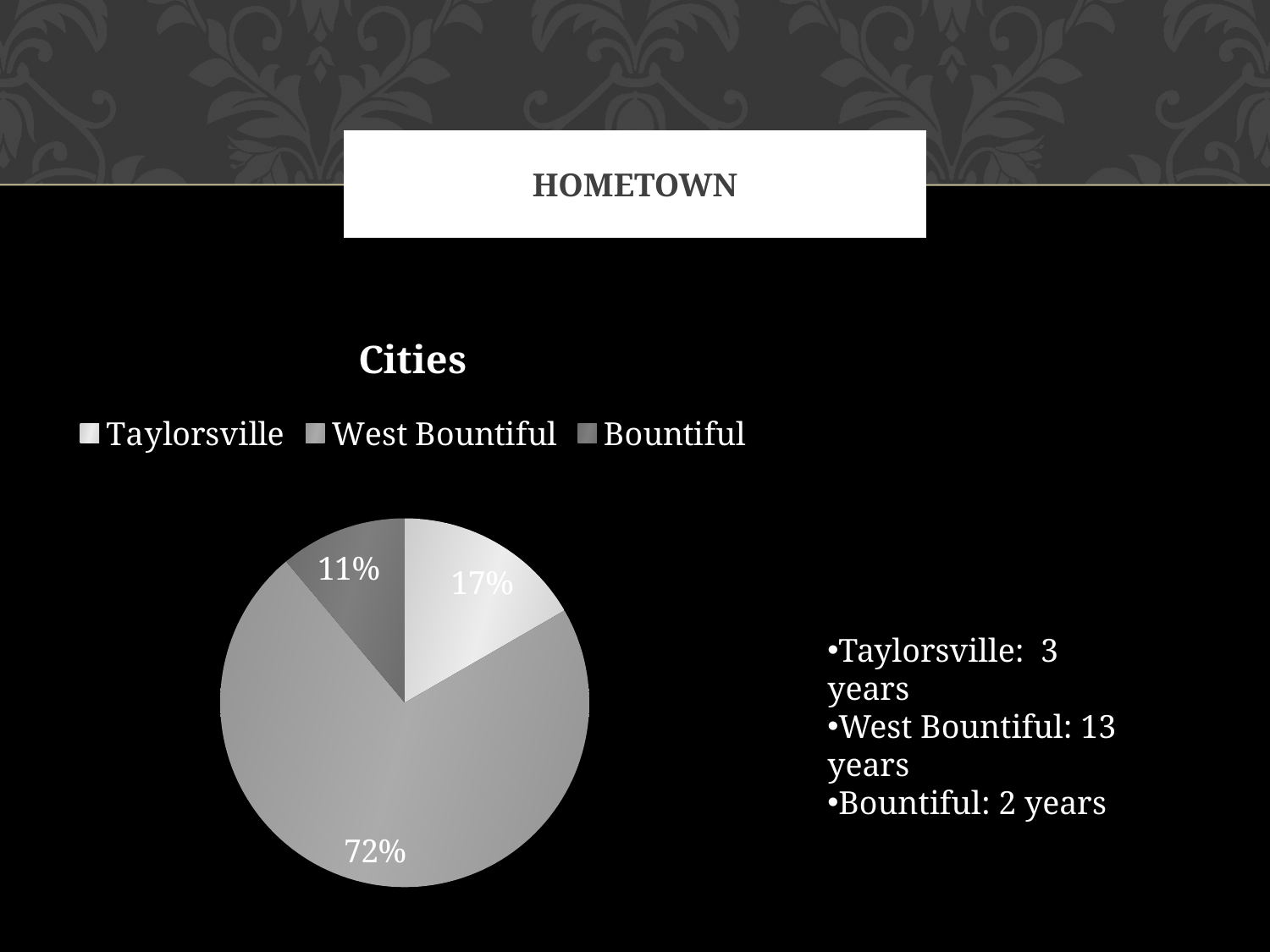
Which legend entry is listed first in the chart legend? Taylorsville What share of the pie does West Bountiful represent? 72% Which slice is larger, Taylorsville or Bountiful? Taylorsville Which city has the largest slice of the pie? West Bountiful How many entries does the chart legend list? 3 What kind of chart is shown on the slide? pie chart What share of the pie does Bountiful represent? 11% How many slices does the pie chart have? 3 What is the difference in percentage points between the West Bountiful slice and the Taylorsville slice? 55 What is the title of the chart? Cities What share of the pie does Taylorsville represent? 17% Which city has the smallest slice of the pie? Bountiful